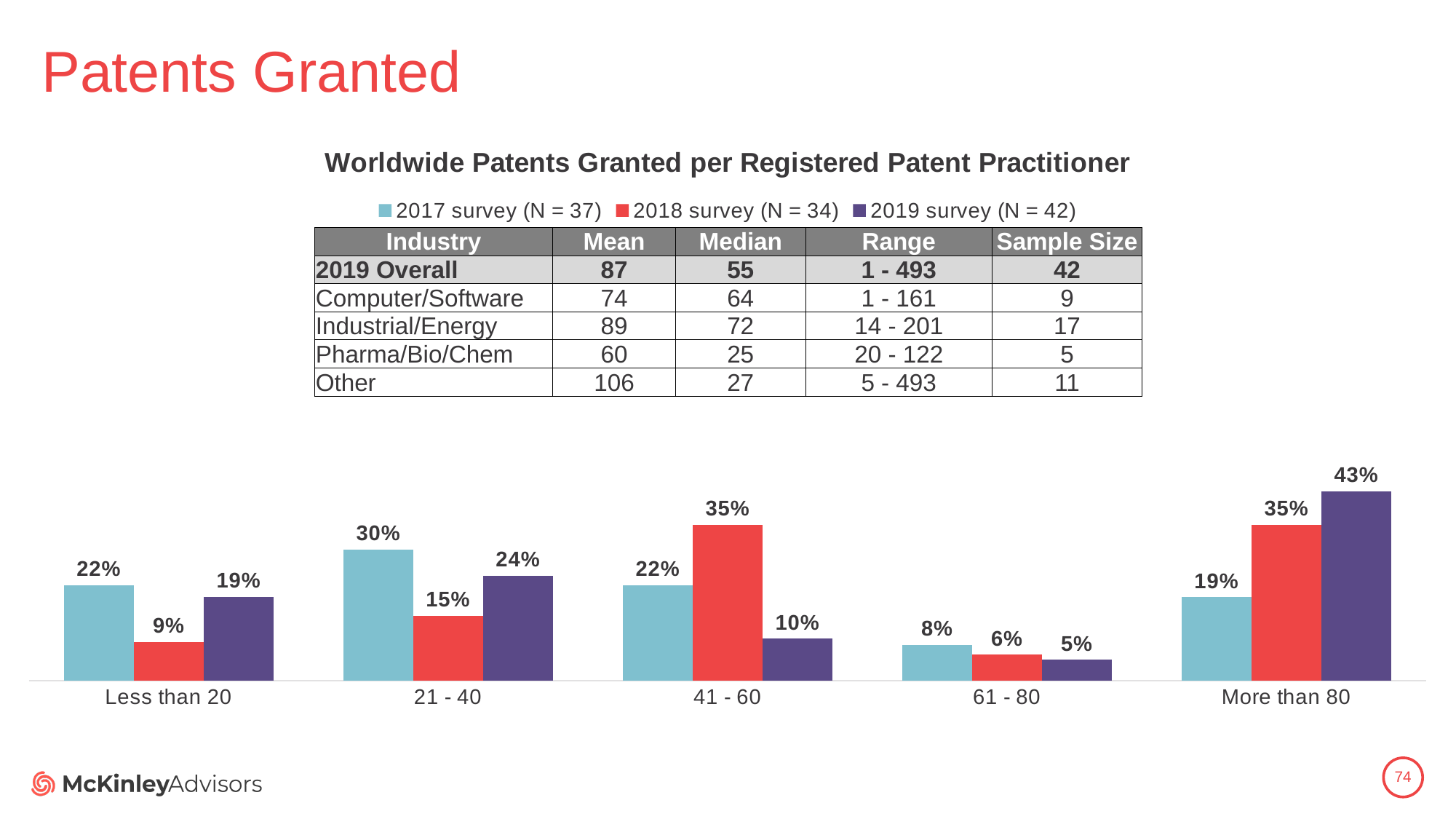
What is the value for the 2017 survey in the '21 - 40' category? 30% What is the sample size for the 2019 survey according to the legend? 42 Which category has the lowest value for the 2019 survey? 61 - 80 What is the value for the 2019 survey in the 'More than 80' category? 43% In the '41 - 60' category, which is larger: the 2017 survey value or the 2018 survey value? 2018 survey Which category has the highest value for the 2018 survey? 41 - 60 and More than 80 (tied at 35%) How many categories are shown on the x axis of the chart? 5 What is the title of the chart? Worldwide Patents Granted per Registered Patent Practitioner What kind of chart is shown on the slide? Bar chart What is the value for the 2018 survey in the 'Less than 20' category? 9% What is the difference between the 2019 survey and 2017 survey values in the 'More than 80' category? 24% How many series does the chart legend list? 3